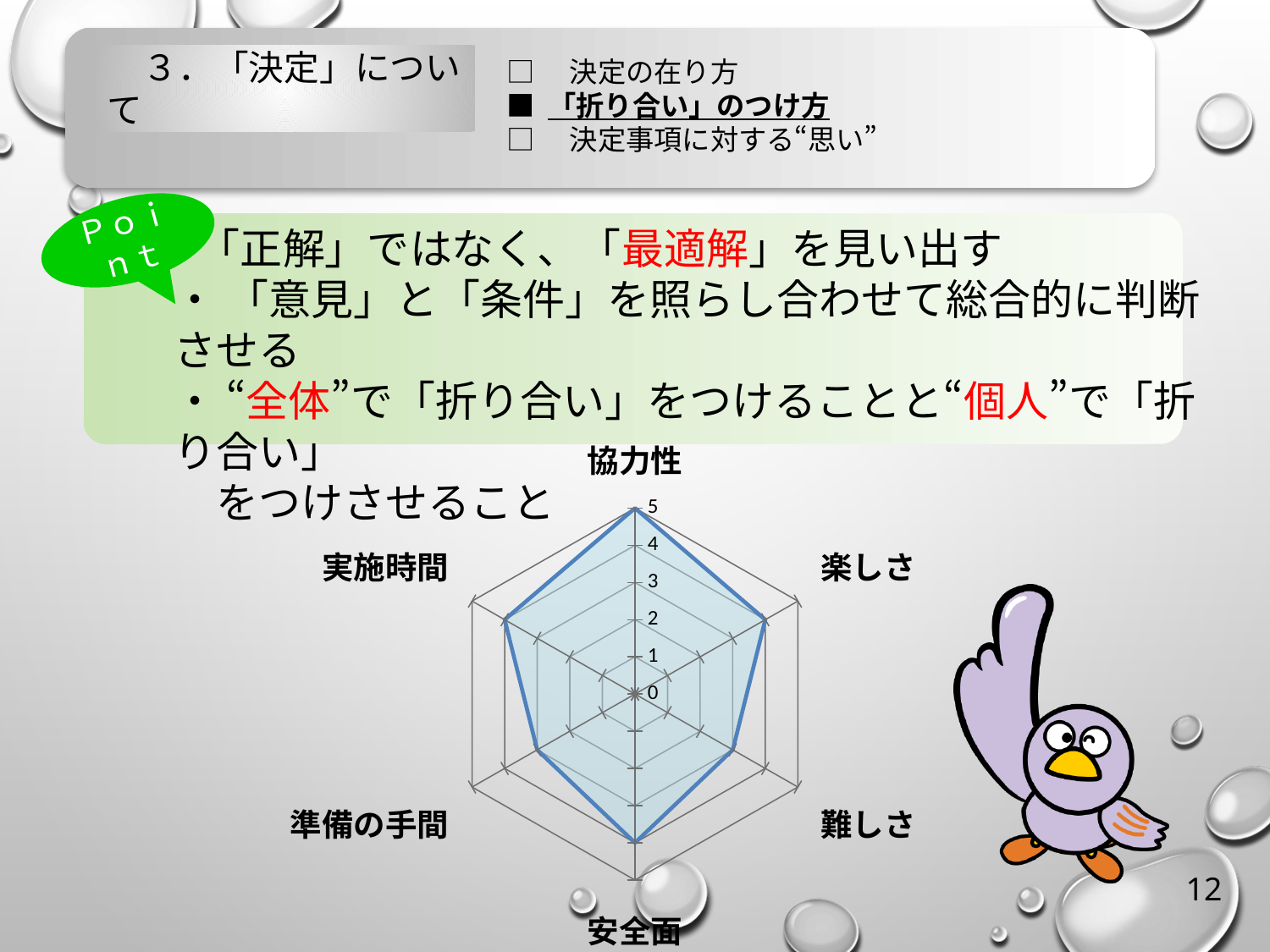
What is the value for 安全面 in the radar chart? 4 Is the value for 準備の手間 greater or less than 4? less How many categories (axes) does the radar chart have? 6 What kind of chart is shown on the slide? Radar chart Which category has the highest value in the radar chart? 協力性 What is the maximum value shown on the radar chart's scale? 5 Is the value for 実施時間 greater or less than 2? greater Which category label appears at the top of the radar chart? 協力性 Is the value for 楽しさ greater or less than 3? greater What is the value for 協力性 in the radar chart? 5 Which is larger in the radar chart, the value for 協力性 or the value for 準備の手間? 協力性